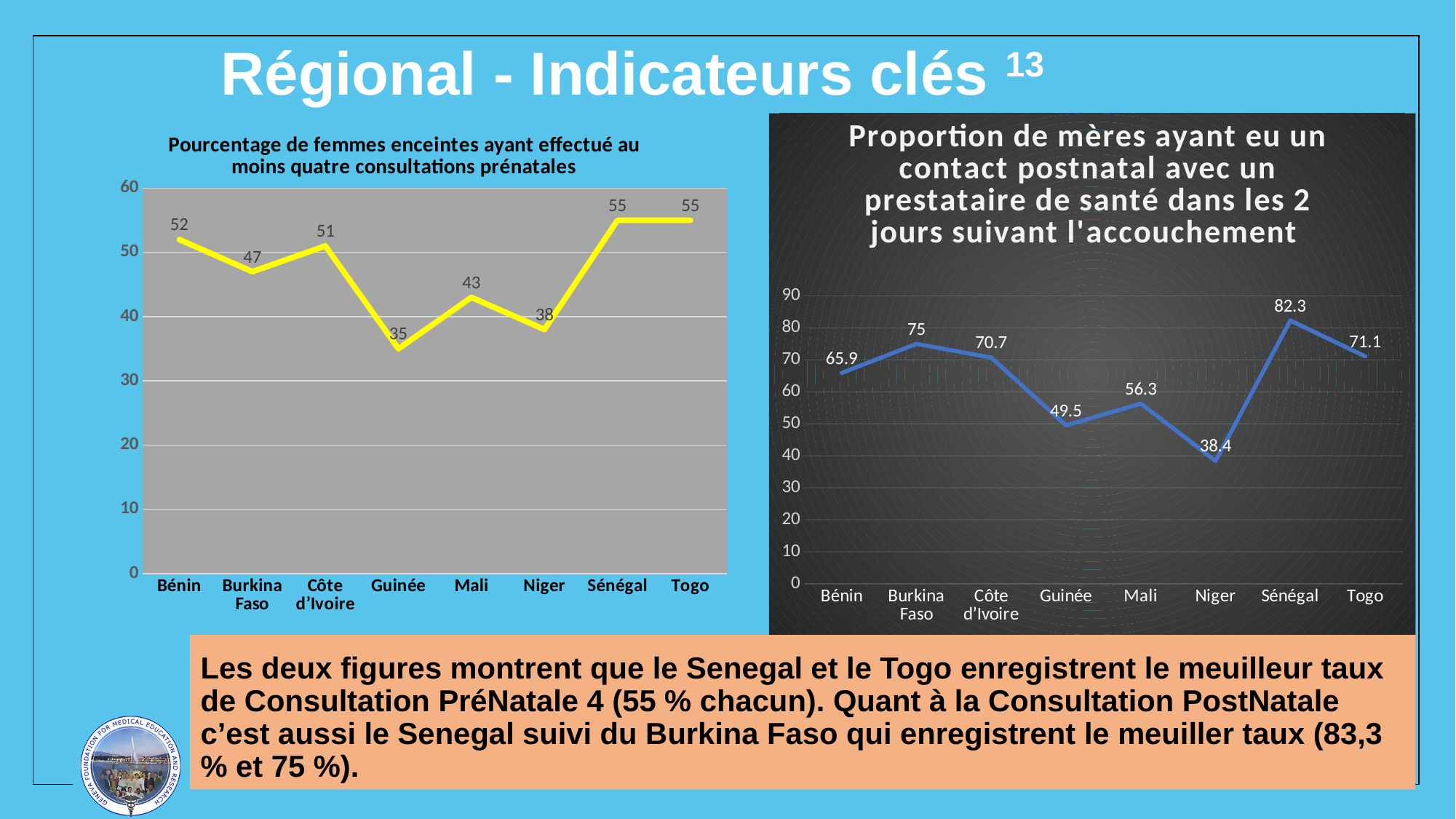
What colour is the line in the left chart (Pourcentage de femmes enceintes ayant effectué au moins quatre consultations prénatales)? Yellow In the right chart (Proportion de mères ayant eu un contact postnatal), what is the value for Mali? 56.3 In the left chart (Pourcentage de femmes enceintes ayant effectué au moins quatre consultations prénatales), what is the value for Côte d'Ivoire? 51 In the right chart (Proportion de mères ayant eu un contact postnatal), what is the difference between Sénégal and Niger? 43.9 What type of chart is the left chart (Pourcentage de femmes enceintes ayant effectué au moins quatre consultations prénatales)? Line chart In the left chart (Pourcentage de femmes enceintes ayant effectué au moins quatre consultations prénatales), what is the difference between Bénin and Niger? 14 In the left chart (Pourcentage de femmes enceintes ayant effectué au moins quatre consultations prénatales), how many countries are plotted? 8 In the right chart (Proportion de mères ayant eu un contact postnatal), what is the value for Sénégal? 82.3 In the right chart (Proportion de mères ayant eu un contact postnatal), which country has the lowest value? Niger In the right chart (Proportion de mères ayant eu un contact postnatal), which is larger, Burkina Faso or Togo? Burkina Faso In the left chart (Pourcentage de femmes enceintes ayant effectué au moins quatre consultations prénatales), which country has the lowest value? Guinée In the left chart (Pourcentage de femmes enceintes ayant effectué au moins quatre consultations prénatales), what is the value for Guinée? 35